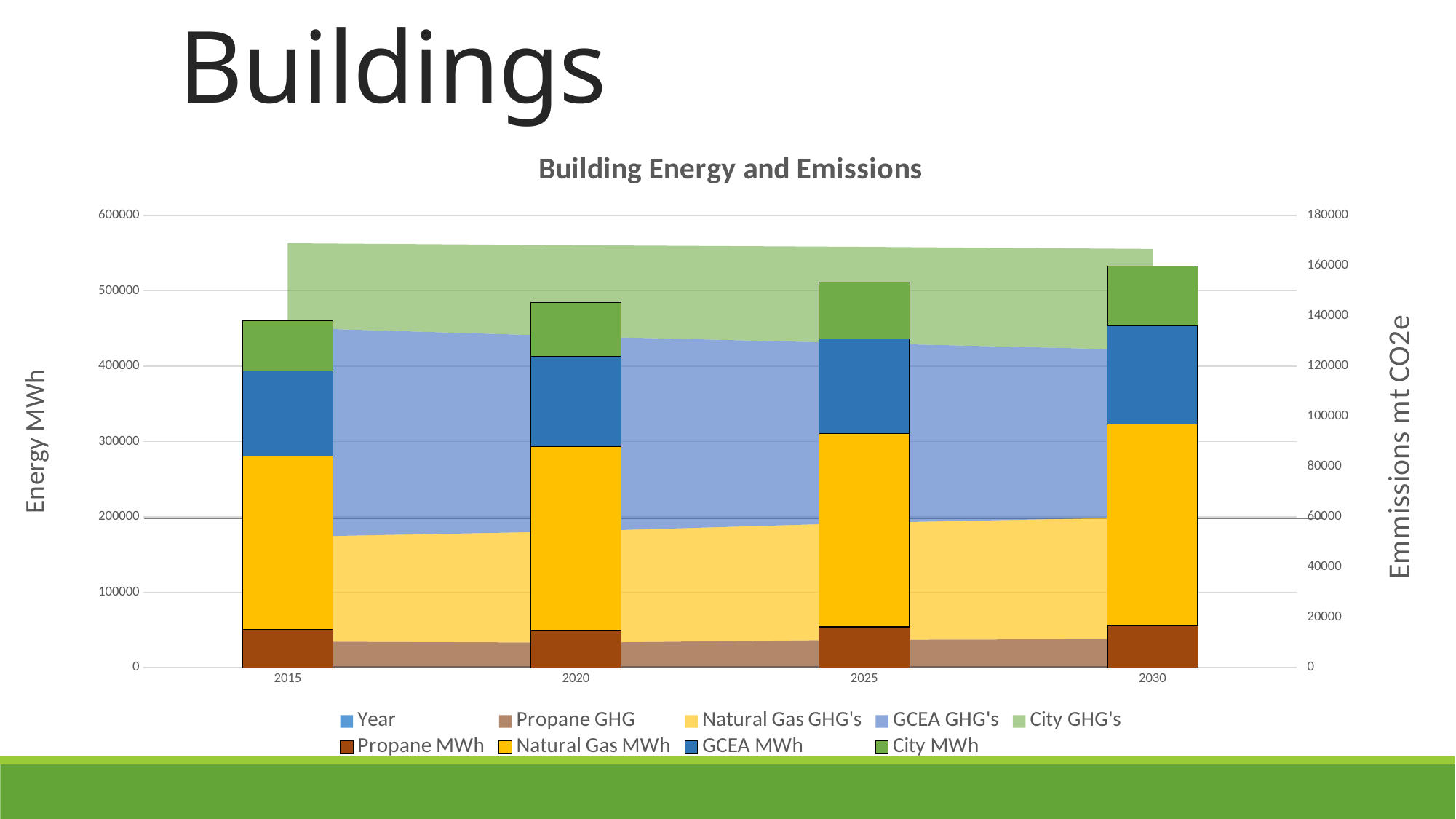
What is the label of the right-hand vertical axis? Emmissions mt CO2e How many years are shown on the x axis of the chart? 4 Which year has the tallest stacked bar in the chart? 2030 What is the title of the chart on the slide? Building Energy and Emissions Is the total height of the 2020 stacked bar greater or less than 500000 MWh? less How many entries does the chart's legend list? 9 What kind of chart is shown on the slide? Stacked bar chart combined with a stacked area chart Do the total stacked bar heights (Energy MWh) rise or fall from 2015 to 2030? rise Is the total height of the 2030 stacked bar greater or less than 500000 MWh? greater Which year has the shortest stacked bar in the chart? 2015 Is the total height of the 2015 stacked bar greater or less than 500000 MWh? less Which stacked bar is taller, 2020 or 2030? 2030